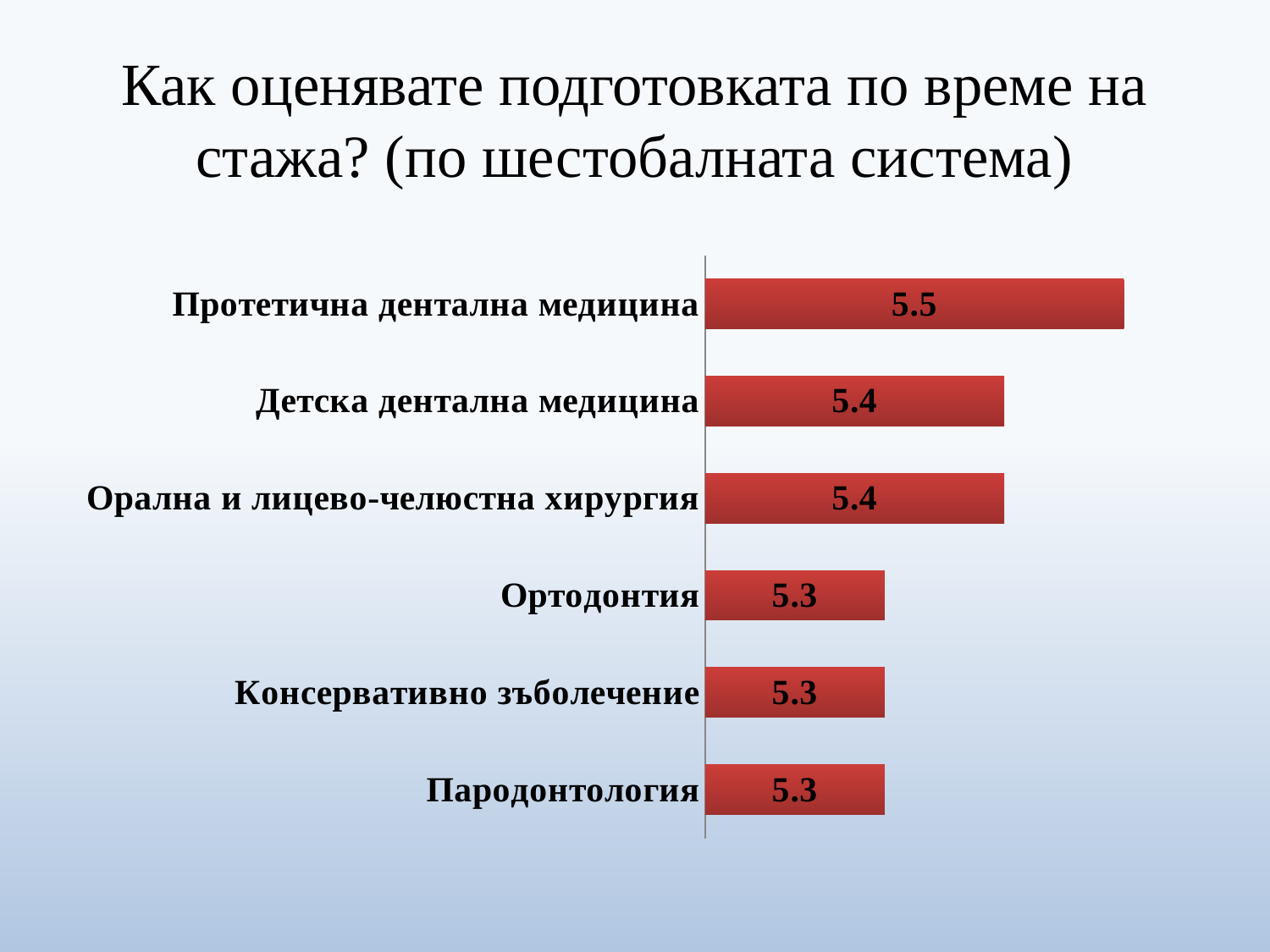
Which is larger, the value for Протетична дентална медицина or the value for Консервативно зъболечение? Протетична дентална медицина What is the difference between the values for Протетична дентална медицина and Пародонтология? 0.2 What is the value for Пародонтология? 5.3 What is the value for Детска дентална медицина? 5.4 What is the value for Орална и лицево-челюстна хирургия? 5.4 How many categories are shown in the chart? 6 Which category has the highest value? Протетична дентална медицина What is the difference between the values for Детска дентална медицина and Ортодонтия? 0.1 What is the value for Протетична дентална медицина? 5.5 What kind of chart is shown on the slide? Bar chart What is the value for Ортодонтия? 5.3 What colour are the bars in the chart? Red